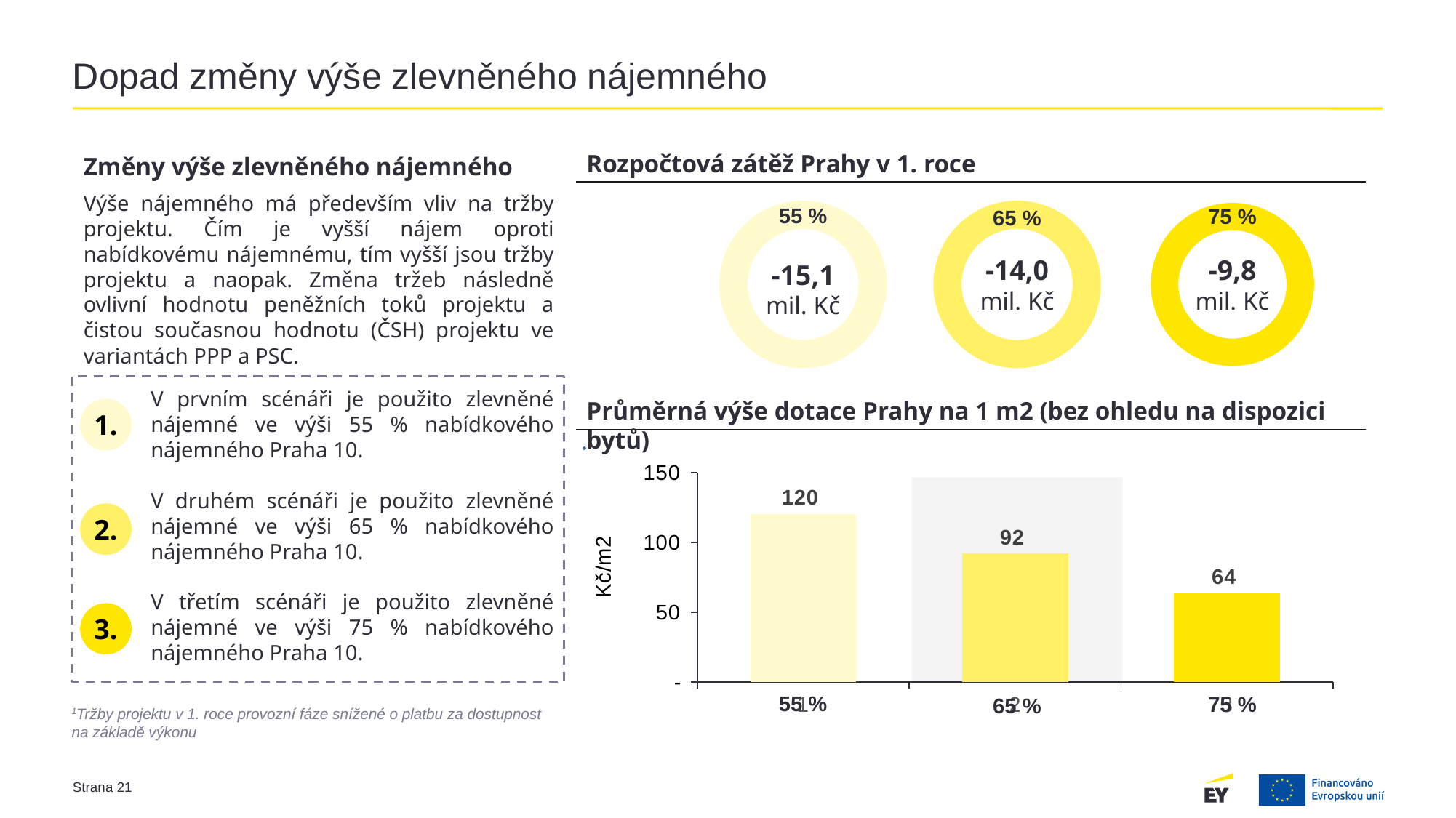
In the chart 'Průměrná výše dotace Prahy na 1 m2', which is larger, the value for 55 % or the value for 65 %? 55 % In the chart 'Průměrná výše dotace Prahy na 1 m2', what is the value for 55 %? 120 In the chart 'Průměrná výše dotace Prahy na 1 m2', which category has the lowest value? 75 % In the chart 'Průměrná výše dotace Prahy na 1 m2', how many bars are plotted? 3 What kind of chart is 'Průměrná výše dotace Prahy na 1 m2'? bar chart In the chart 'Průměrná výše dotace Prahy na 1 m2', what is the difference between the values for 65 % and 75 %? 28 In the chart 'Průměrná výše dotace Prahy na 1 m2', what is the difference between the values for 55 % and 75 %? 56 In the chart 'Průměrná výše dotace Prahy na 1 m2', what is the value for 75 %? 64 In the chart 'Průměrná výše dotace Prahy na 1 m2', which category has the highest value? 55 % What is the label of the vertical axis in the chart 'Průměrná výše dotace Prahy na 1 m2'? Kč/m2 In the chart 'Průměrná výše dotace Prahy na 1 m2', do the values rise or fall from left to right along the x axis? fall In the chart 'Průměrná výše dotace Prahy na 1 m2', what is the value for 65 %? 92